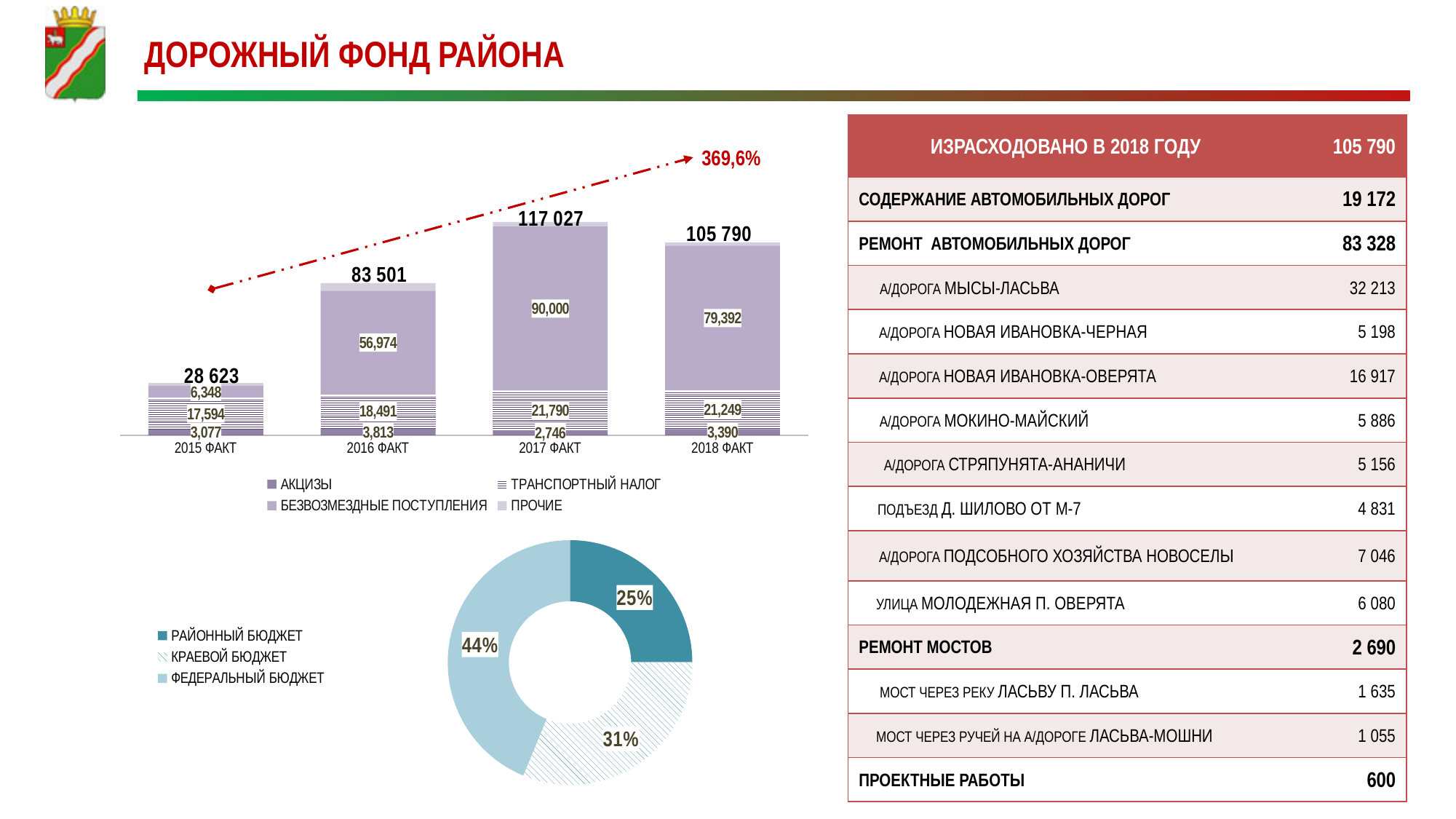
In the top-left bar chart, which is larger: АКЦИЗЫ in 2016 ФАКТ or АКЦИЗЫ in 2017 ФАКТ? 2016 ФАКТ In the donut chart at the bottom, what share does ФЕДЕРАЛЬНЫЙ БЮДЖЕТ have? 44% In the donut chart at the bottom, which budget source has the smallest share? РАЙОННЫЙ БЮДЖЕТ In the top-left bar chart, which year has the highest total? 2017 ФАКТ How many series does the legend of the top-left bar chart list? 4 How many years (categories) are shown in the top-left bar chart? 4 In the top-left bar chart, what is the value of БЕЗВОЗМЕЗДНЫЕ ПОСТУПЛЕНИЯ for 2016 ФАКТ? 56,974 What kind of chart is the top-left chart showing 2015–2018 ФАКТ? Stacked bar chart In the top-left bar chart, what is the value of ТРАНСПОРТНЫЙ НАЛОГ for 2018 ФАКТ? 21,249 In the top-left bar chart, what is the total value for 2017 ФАКТ? 117 027 In the top-left bar chart, which year has the lowest total? 2015 ФАКТ In the top-left bar chart, what is the difference between the totals for 2017 ФАКТ and 2018 ФАКТ? 11 237